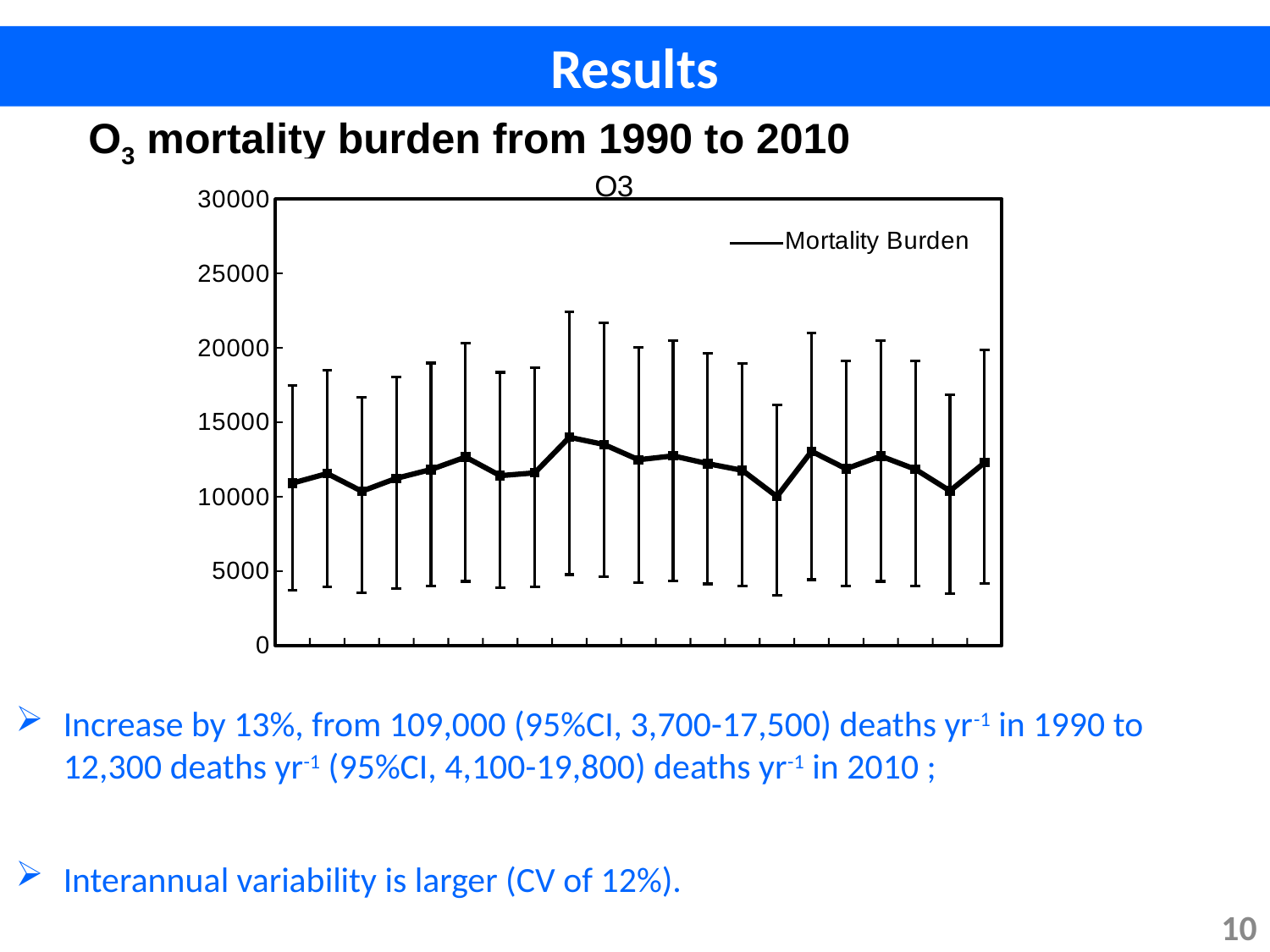
How many series does the legend of the O3 chart list? 1 How many data points are plotted on the Mortality Burden line? 21 Is the last point of the Mortality Burden line greater or less than 10000? greater Is the lowest point of the Mortality Burden line greater or less than 5000? greater What is the lowest value shown on the y axis of the O3 chart? 0 Is the highest point of the Mortality Burden line greater or less than 15000? less What is the title printed above the chart? O3 Is the last point of the Mortality Burden line higher or lower than the first point? higher What kind of chart is shown on the slide? line chart What is the highest value shown on the y axis of the O3 chart? 30000 What is the name of the series shown in the legend of the O3 chart? Mortality Burden